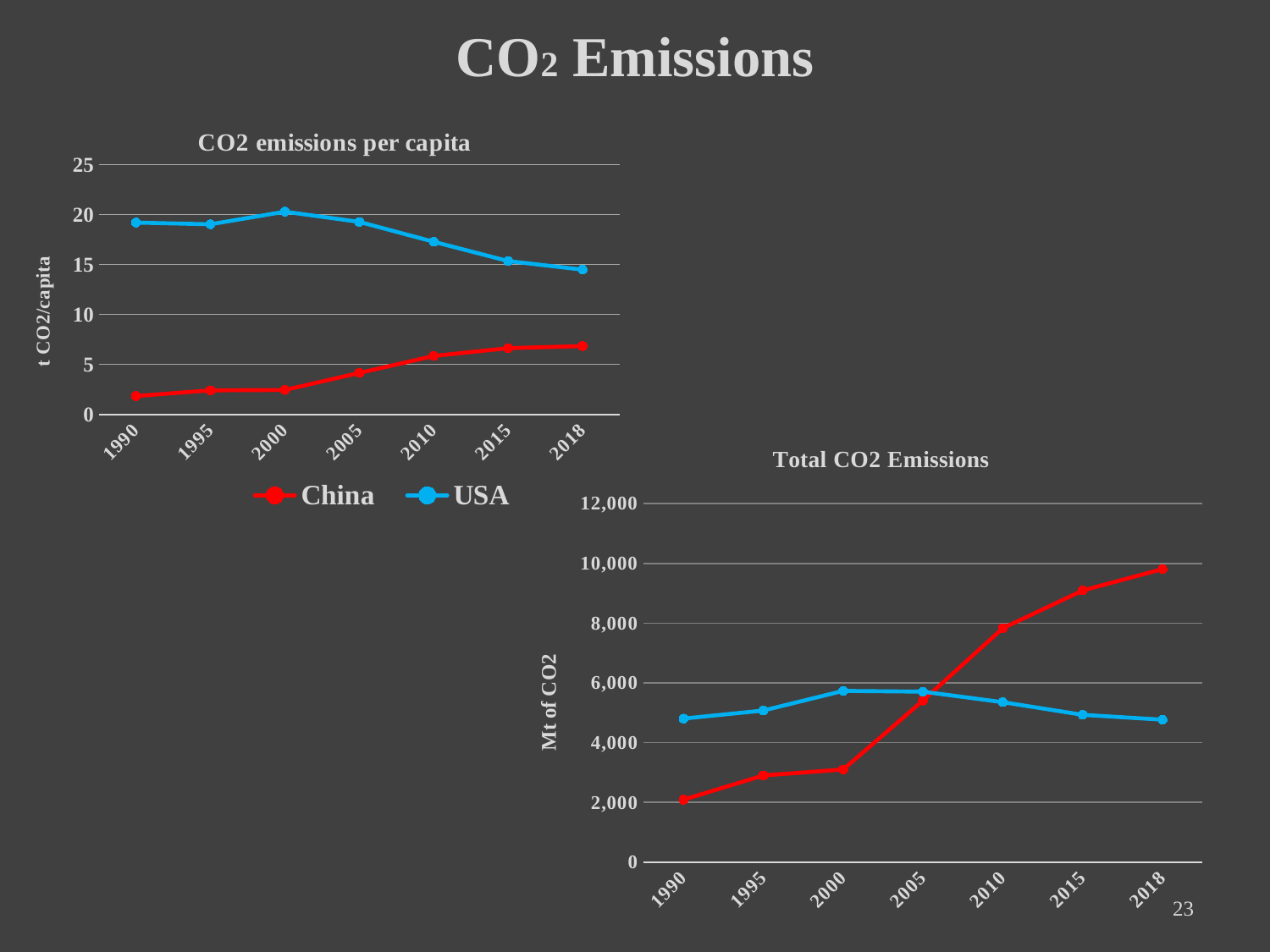
How many series does the legend of the 'CO2 emissions per capita' chart list? 2 In the 'Total CO2 Emissions' chart, is the China value for 2010 greater or less than 6,000? greater What kind of chart is the 'CO2 emissions per capita' chart? line chart In the 'CO2 emissions per capita' chart, is the USA value for 1990 greater or less than 15? greater What is the y-axis label of the 'Total CO2 Emissions' chart? Mt of CO2 In the 'CO2 emissions per capita' chart, in which year is the USA value highest? 2000 In the 'CO2 emissions per capita' chart, is the China value for 2018 greater or less than 5? greater In the 'Total CO2 Emissions' chart, which is larger in 2010, China or USA? China In the 'CO2 emissions per capita' chart, in which year is the China value lowest? 1990 In the 'Total CO2 Emissions' chart, which is larger in 2000, China or USA? USA In the 'Total CO2 Emissions' chart, does the China line rise or fall from 1990 to 2018? rise How many years are plotted along the x axis of the 'Total CO2 Emissions' chart? 7